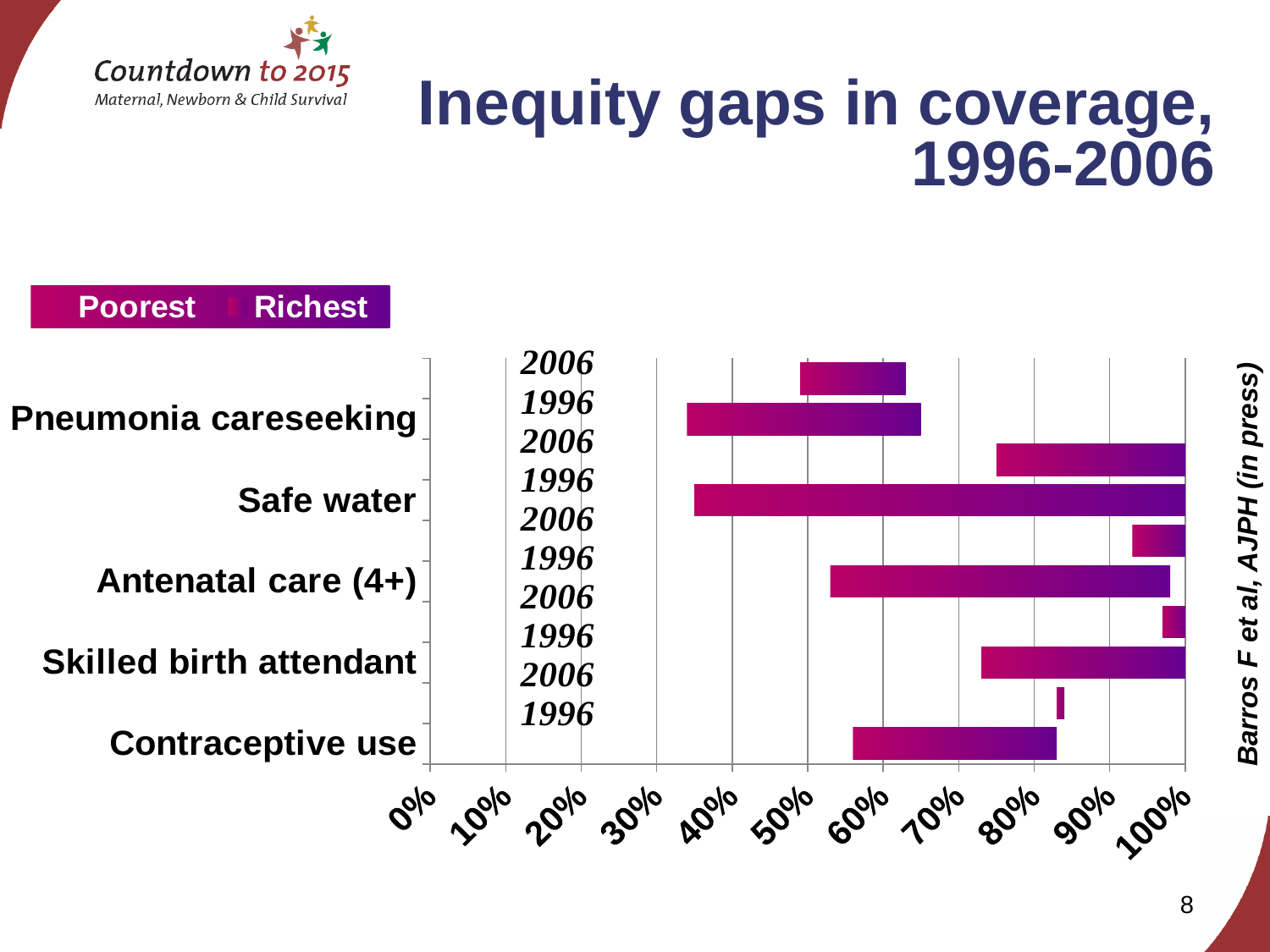
What is the title of the chart slide? Inequity gaps in coverage, 1996-2006 What are the two legend entries of the chart? Poorest and Richest How many indicators (categories) are listed on the vertical axis of the chart? 5 Which indicator shows the narrowest gap between poorest and richest in 2006? Contraceptive use Is the 2006 poorest value for Pneumonia careseeking greater or less than 40%? greater How many entries does the chart legend list? 2 Is the 1996 poorest value for Skilled birth attendant greater or less than 70%? greater Which indicator shows the widest gap between poorest and richest in 1996? Safe water Is the 2006 gap between poorest and richest wider for Safe water or for Antenatal care (4+)? Safe water What kind of chart is shown on the slide? bar chart From 1996 to 2006, did the poorest-richest gap for Skilled birth attendant widen or narrow? narrow Is the 1996 poorest value for Safe water greater or less than 40%? less